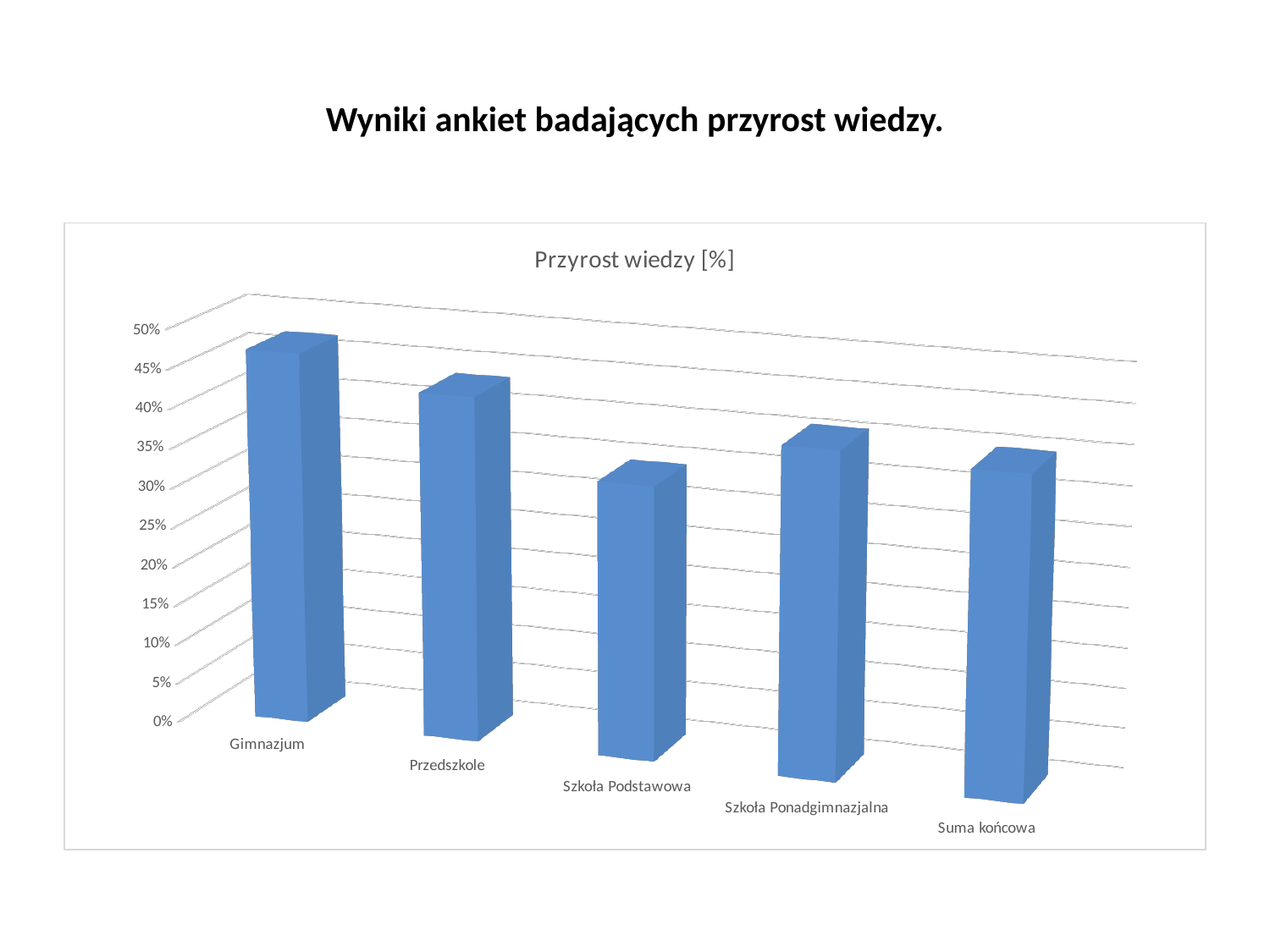
Which is larger, the value for Przedszkole or the value for Szkoła Podstawowa? Przedszkole Which category has the lowest value? Szkoła Podstawowa Which category has the highest value? Gimnazjum Is the value for Szkoła Podstawowa greater or less than 40%? less Is the value for Gimnazjum greater or less than 40%? greater Is the value for Suma końcowa greater or less than 45%? less What kind of chart is shown on the slide? bar chart How many categories are plotted in the chart? 5 What is the title of the chart? Przyrost wiedzy [%] Which is larger, the value for Gimnazjum or the value for Szkoła Podstawowa? Gimnazjum Do the values rise or fall from Gimnazjum to Szkoła Podstawowa along the x axis? fall